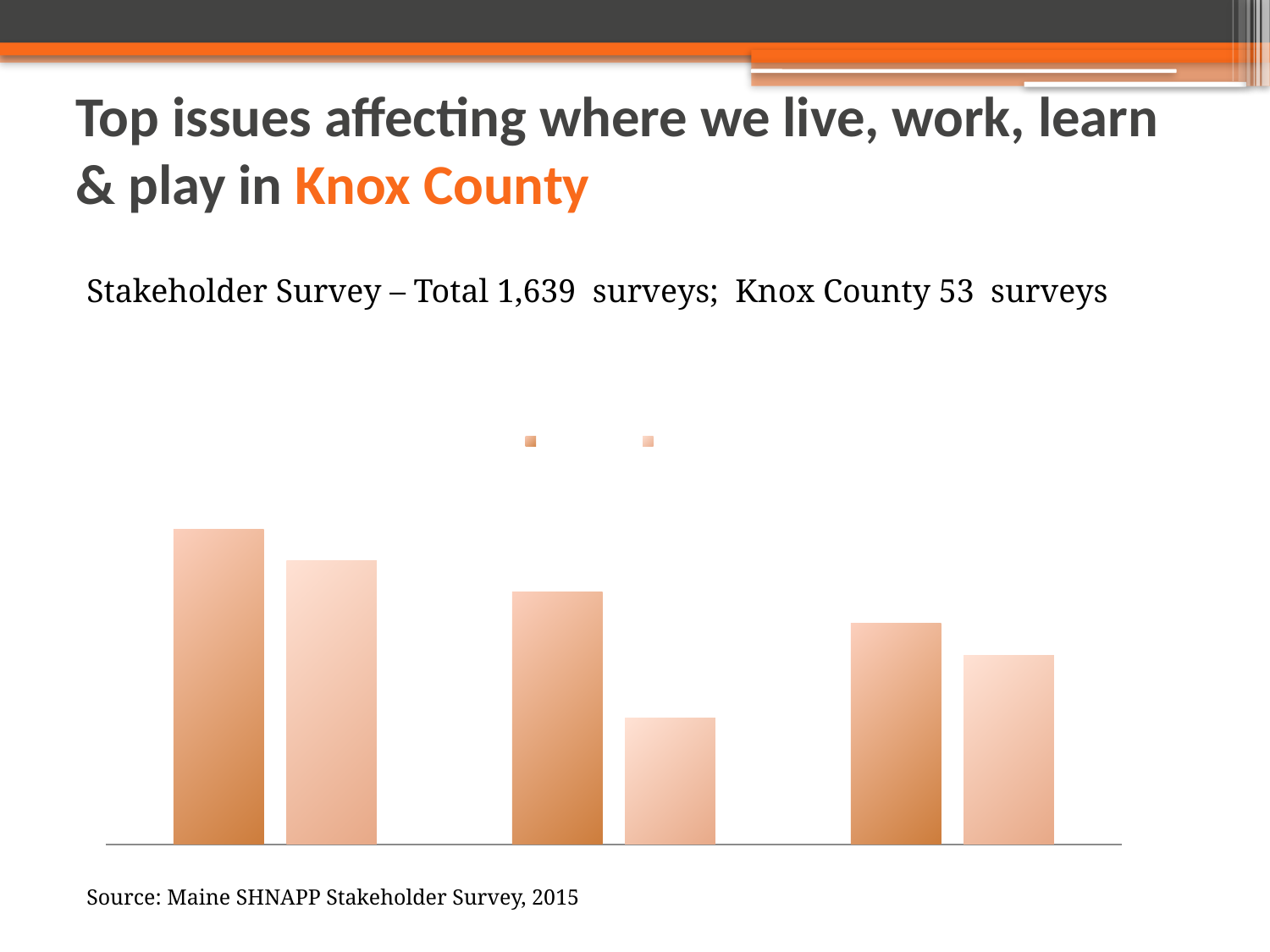
In the leftmost group of bars, is the left (darker) bar or the right (lighter) bar taller? the left (darker) bar Are the bars in the chart vertical or horizontal? vertical How many groups of bars are plotted in the chart? 3 Which group of bars contains the tallest bar in the chart? the leftmost group In the rightmost group of bars, is the left (darker) bar or the right (lighter) bar taller? the left (darker) bar What colour family are the bars in the chart? orange How many series does the chart's legend show? 2 Which group of bars contains the shortest bar in the chart? the middle group In the middle group of bars, is the left (darker) bar or the right (lighter) bar taller? the left (darker) bar Do the darker bars rise or fall from left to right across the chart? fall What kind of chart is shown on the slide? bar chart